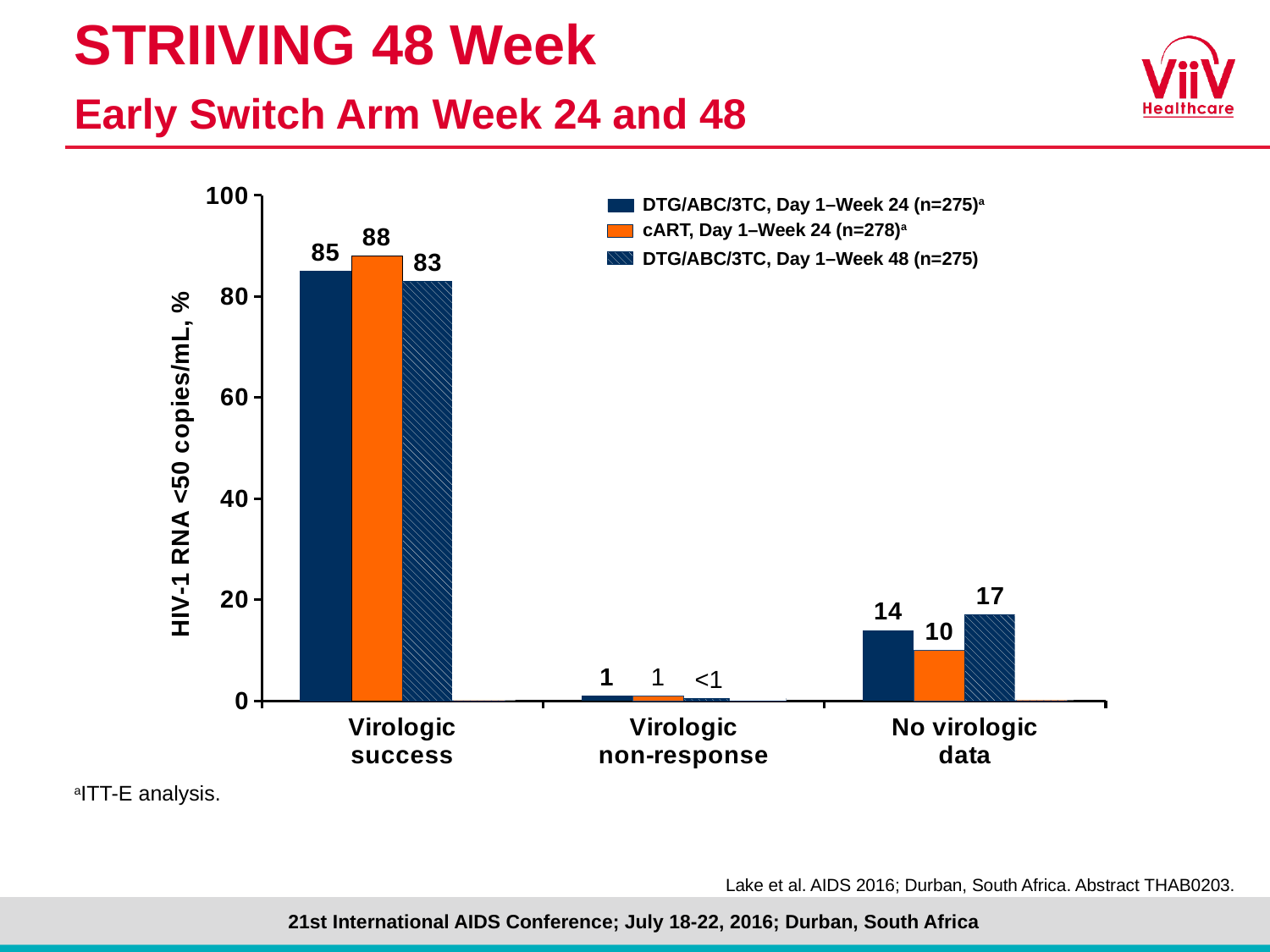
What is the difference between the cART, Day 1–Week 24 and DTG/ABC/3TC, Day 1–Week 48 values in the Virologic success category? 5 What kind of chart is shown on the slide? Bar chart What is the value for DTG/ABC/3TC, Day 1–Week 24 in the Virologic success category? 85 What is the value for cART, Day 1–Week 24 in the Virologic success category? 88 How many series does the legend list? 3 What is the value for DTG/ABC/3TC, Day 1–Week 48 in the No virologic data category? 17 What is the value for DTG/ABC/3TC, Day 1–Week 48 in the Virologic non-response category? <1 Which series has the highest value in the Virologic success category? cART, Day 1–Week 24 Which series has the lowest value in the No virologic data category? cART, Day 1–Week 24 In the No virologic data category, which is larger: DTG/ABC/3TC, Day 1–Week 24 or DTG/ABC/3TC, Day 1–Week 48? DTG/ABC/3TC, Day 1–Week 48 How many categories are shown on the x axis? 3 What is the y-axis label of the chart? HIV-1 RNA <50 copies/mL, %